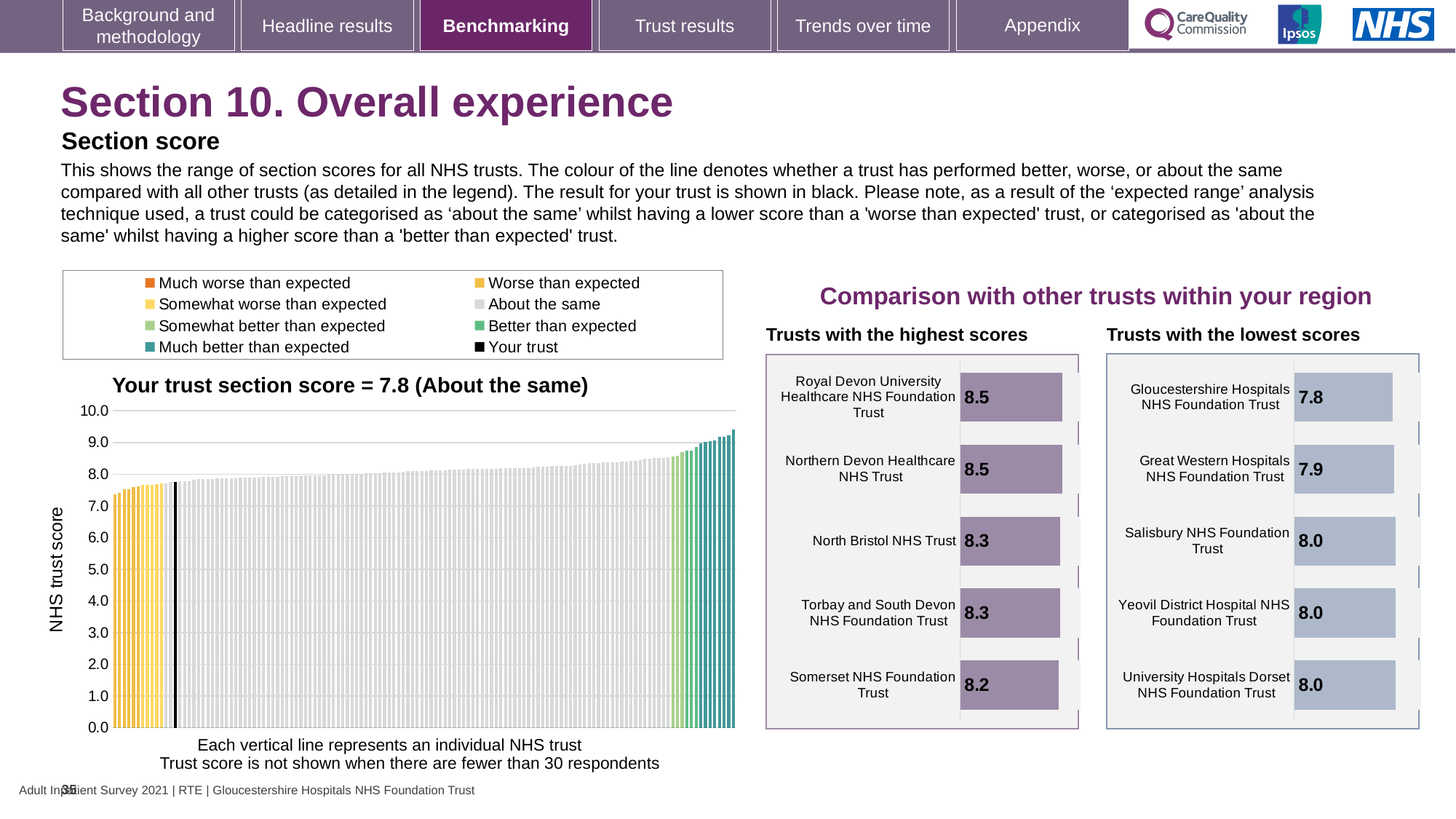
In the 'Trusts with the highest scores' chart, what is the difference between the scores of Royal Devon University Healthcare NHS Foundation Trust and Somerset NHS Foundation Trust? 0.3 In the 'Trusts with the lowest scores' chart, which trust has the lowest score? Gloucestershire Hospitals NHS Foundation Trust In the 'Your trust section score' chart, is the value of the highest bar greater or less than 9.0? greater In the 'Trusts with the highest scores' chart, what is the score for Somerset NHS Foundation Trust? 8.2 In the 'Trusts with the lowest scores' chart, which has the higher score: Great Western Hospitals NHS Foundation Trust or Yeovil District Hospital NHS Foundation Trust? Yeovil District Hospital NHS Foundation Trust In the 'Your trust section score' chart, do the trust scores rise or fall from left to right? rise In the 'Trusts with the highest scores' chart, what is the score for North Bristol NHS Trust? 8.3 In the 'Trusts with the lowest scores' chart, what is the difference between the scores of Salisbury NHS Foundation Trust and Gloucestershire Hospitals NHS Foundation Trust? 0.2 In the 'Trusts with the lowest scores' chart, what is the score for Great Western Hospitals NHS Foundation Trust? 7.9 In the 'Trusts with the highest scores' chart, how many trusts are shown? 5 In the 'Trusts with the highest scores' chart, which trust has the lowest score? Somerset NHS Foundation Trust In the 'Your trust section score' chart, what is the section score for your trust? 7.8